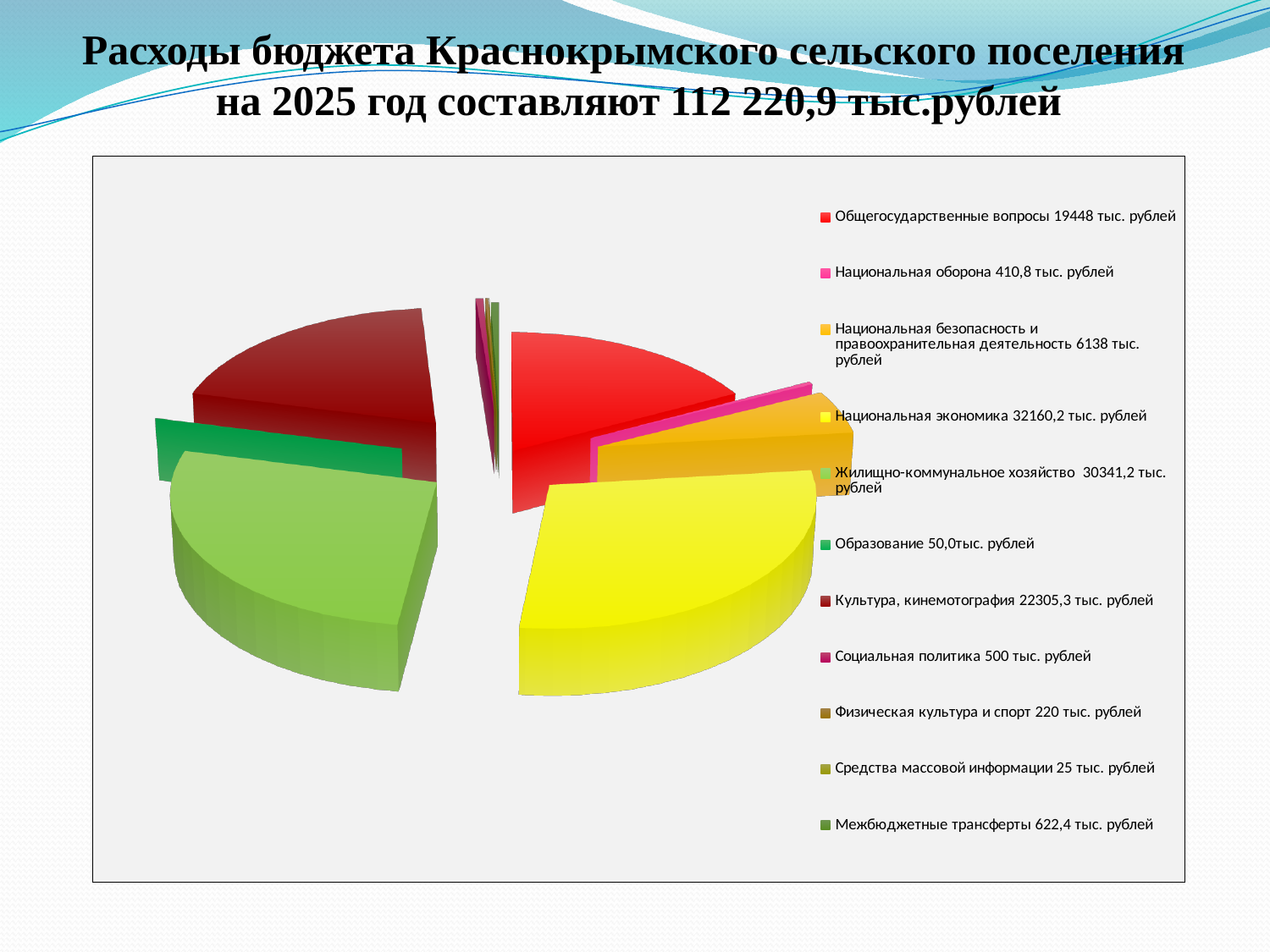
Which category has the largest value? Национальная экономика What is the value for Межбюджетные трансферты? 622,4 тыс. рублей What type of chart is shown on the slide? pie chart What is the difference between Культура, кинемотография and Общегосударственные вопросы? 2857,3 тыс. рублей What is the value for Образование? 50,0 тыс. рублей What is the difference between Национальная экономика and Жилищно-коммунальное хозяйство? 1819 тыс. рублей Which is larger: Национальная безопасность и правоохранительная деятельность or Национальная оборона? Национальная безопасность и правоохранительная деятельность According to the slide title, what is the total budget expenditure for 2025? 112 220,9 тыс.рублей What is the value for Национальная экономика? 32160,2 тыс. рублей What is the value for Культура, кинемотография? 22305,3 тыс. рублей Which category has the smallest value? Средства массовой информации How many categories does the legend of the pie chart list? 11